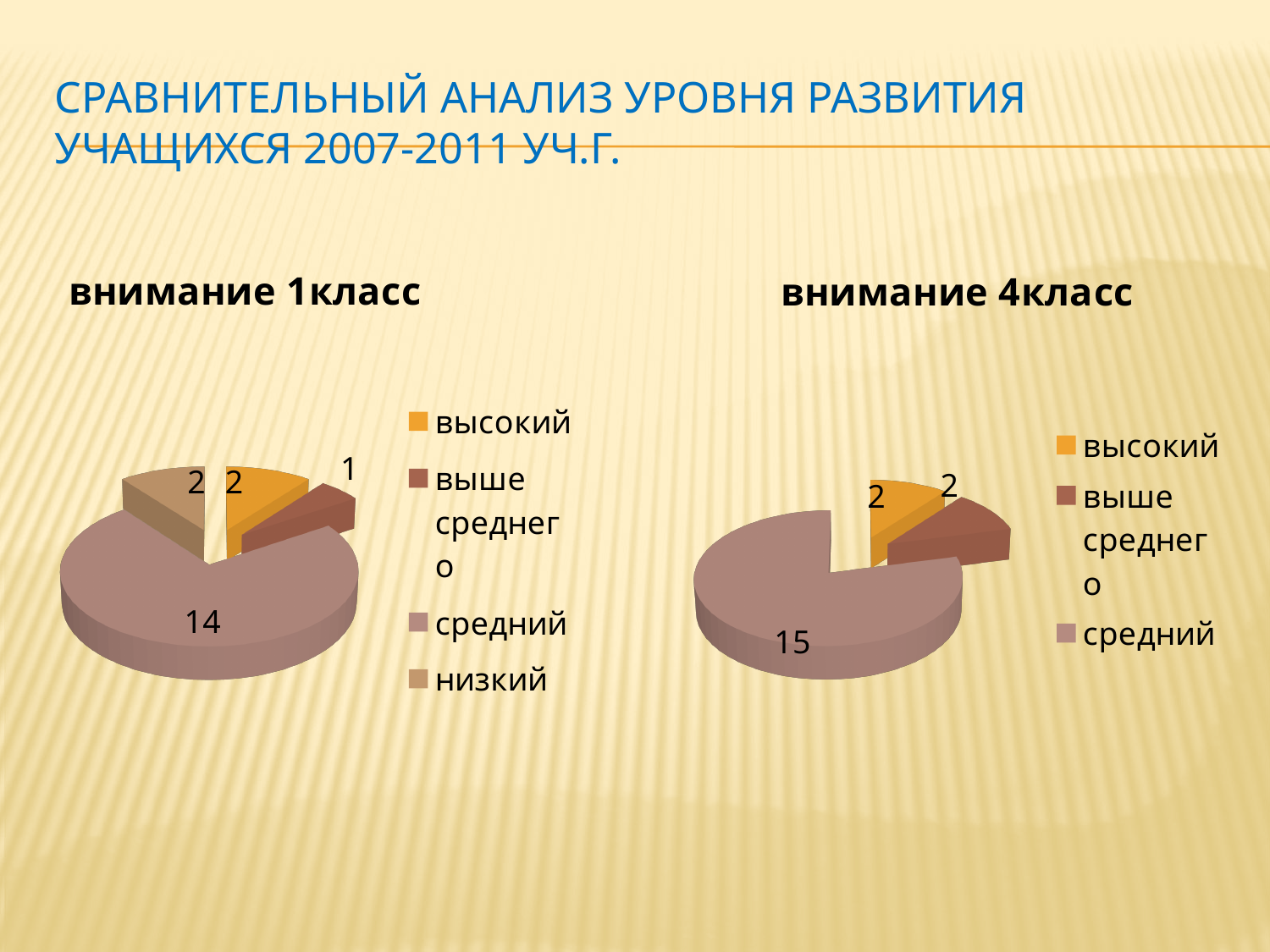
In the chart titled 'внимание 1класс', what is the value for 'выше среднего'? 1 What is the difference between the 'средний' value in the 'внимание 4класс' chart and the 'средний' value in the 'внимание 1класс' chart? 1 In the chart titled 'внимание 4класс', what is the value for 'средний'? 15 How many categories does the legend of the 'внимание 4класс' chart list? 3 In the chart titled 'внимание 4класс', which category has the largest slice? средний How many categories does the legend of the 'внимание 1класс' chart list? 4 In the chart titled 'внимание 1класс', what is the value for 'средний'? 14 In the chart titled 'внимание 1класс', which category has the largest slice? средний In the chart titled 'внимание 1класс', which category has the smallest slice? выше среднего In the chart titled 'внимание 4класс', what is the value for 'высокий'? 2 What type of chart is 'внимание 4класс'? pie chart In the chart titled 'внимание 1класс', which is larger: 'средний' or 'низкий'? средний